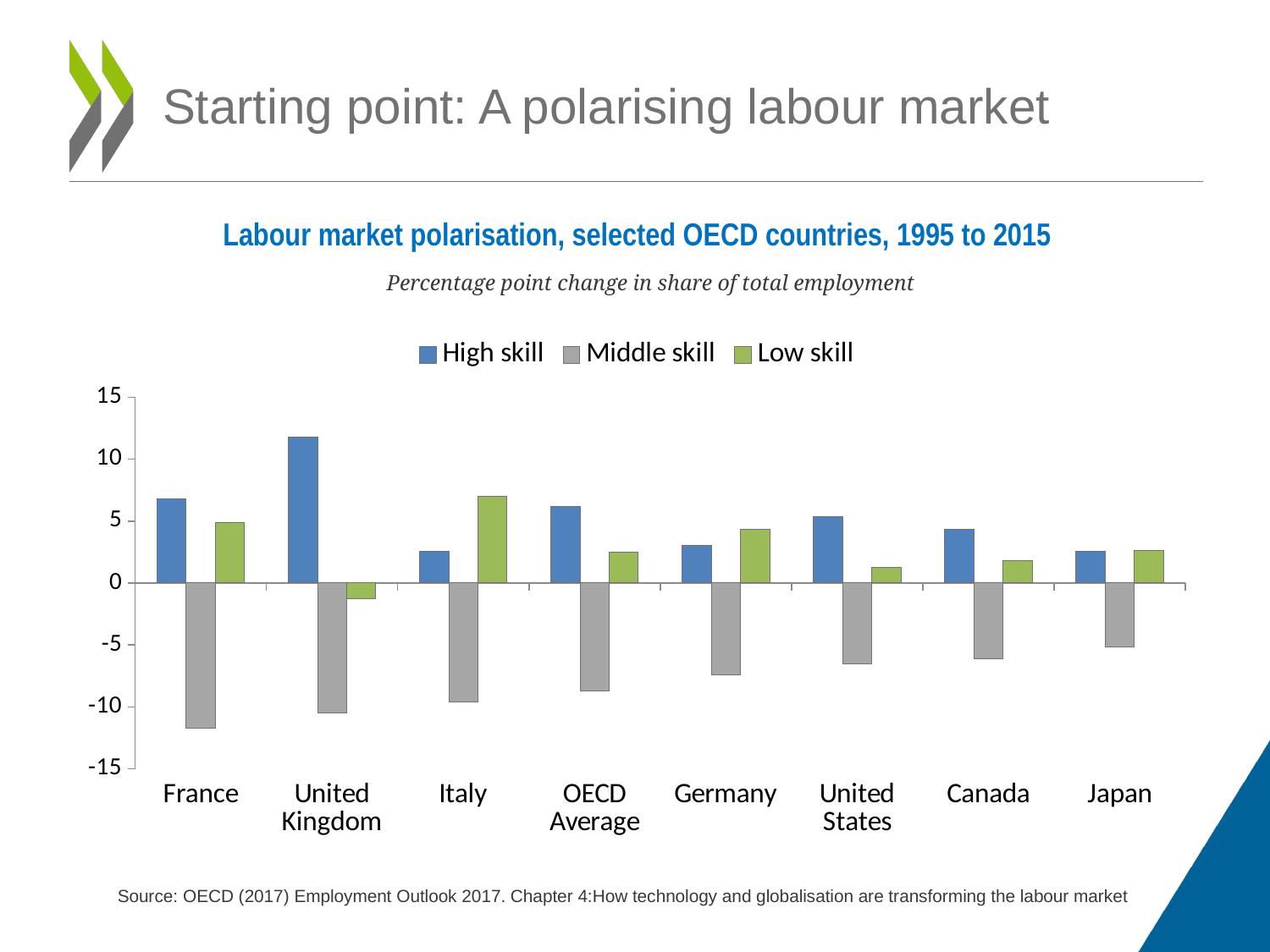
Which country has the highest Low skill value? Italy Which country is the only one with a negative Low skill value? United Kingdom Is the High skill value for the United Kingdom greater or less than 10? greater Is the Middle skill value for Germany greater or less than -5? less Is the Middle skill value for France greater or less than -10? less Which is larger, the High skill value for France or the High skill value for Italy? France Which country has the lowest Middle skill value? France What kind of chart is shown on the slide? Bar chart Which country has the highest High skill value? United Kingdom How many series does the legend list? 3 How many countries or groups are shown on the x axis? 8